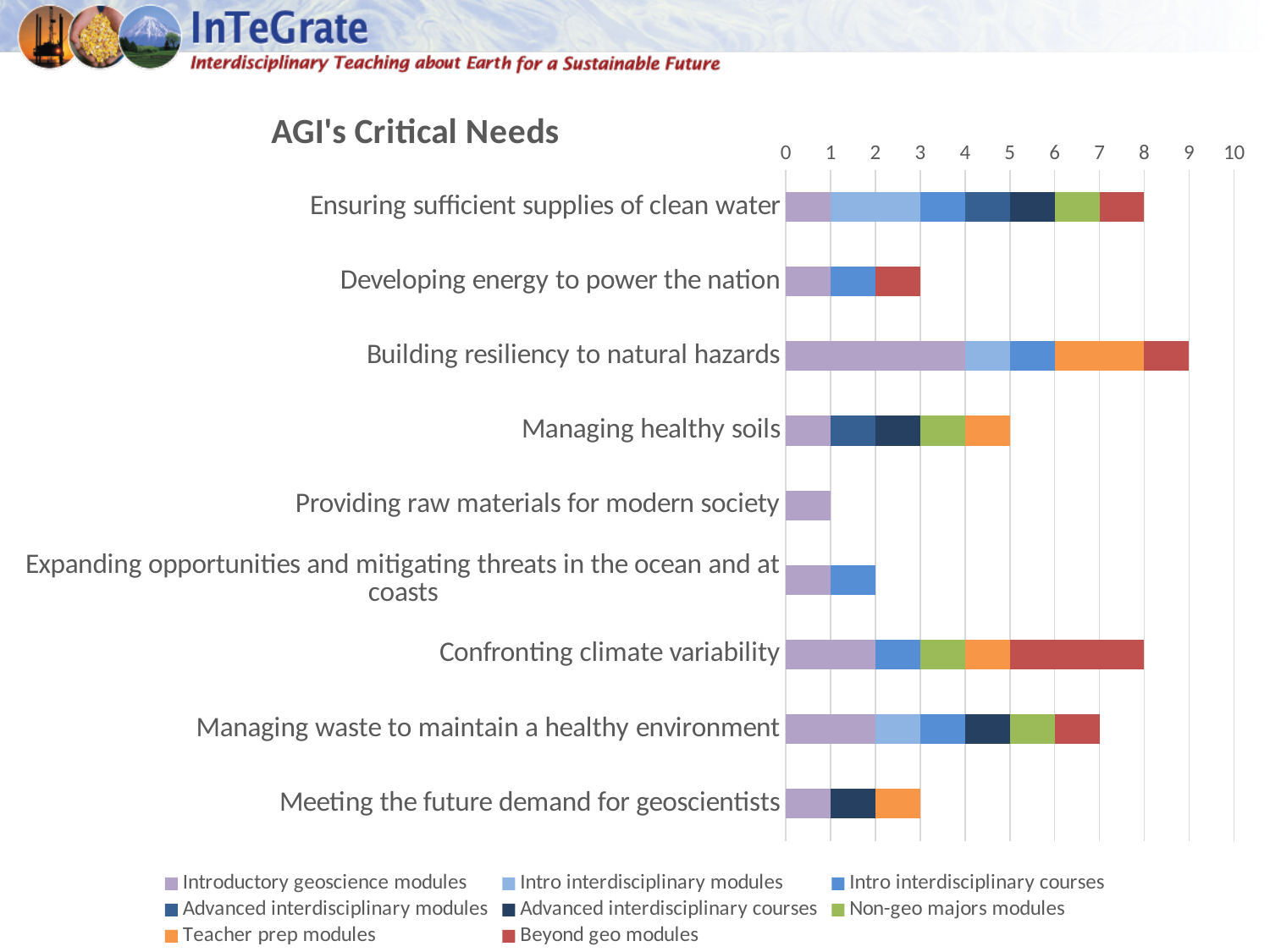
What is the total bar length for 'Managing healthy soils'? 5 What is the title of the chart? AGI's Critical Needs How many series does the legend list? 8 What is the total bar length for 'Building resiliency to natural hazards'? 9 Is the total bar for 'Confronting climate variability' greater or less than 5? greater Which critical need has the shortest total bar? Providing raw materials for modern society Which has a longer total bar: 'Developing energy to power the nation' or 'Managing healthy soils'? Managing healthy soils Which critical need has the longest total bar? Building resiliency to natural hazards What is the difference between the total bar lengths for 'Ensuring sufficient supplies of clean water' and 'Meeting the future demand for geoscientists'? 5 What kind of chart is shown on the slide? Stacked bar chart What is the total bar length for 'Managing waste to maintain a healthy environment'? 7 How many critical needs (categories) are plotted on the chart? 9